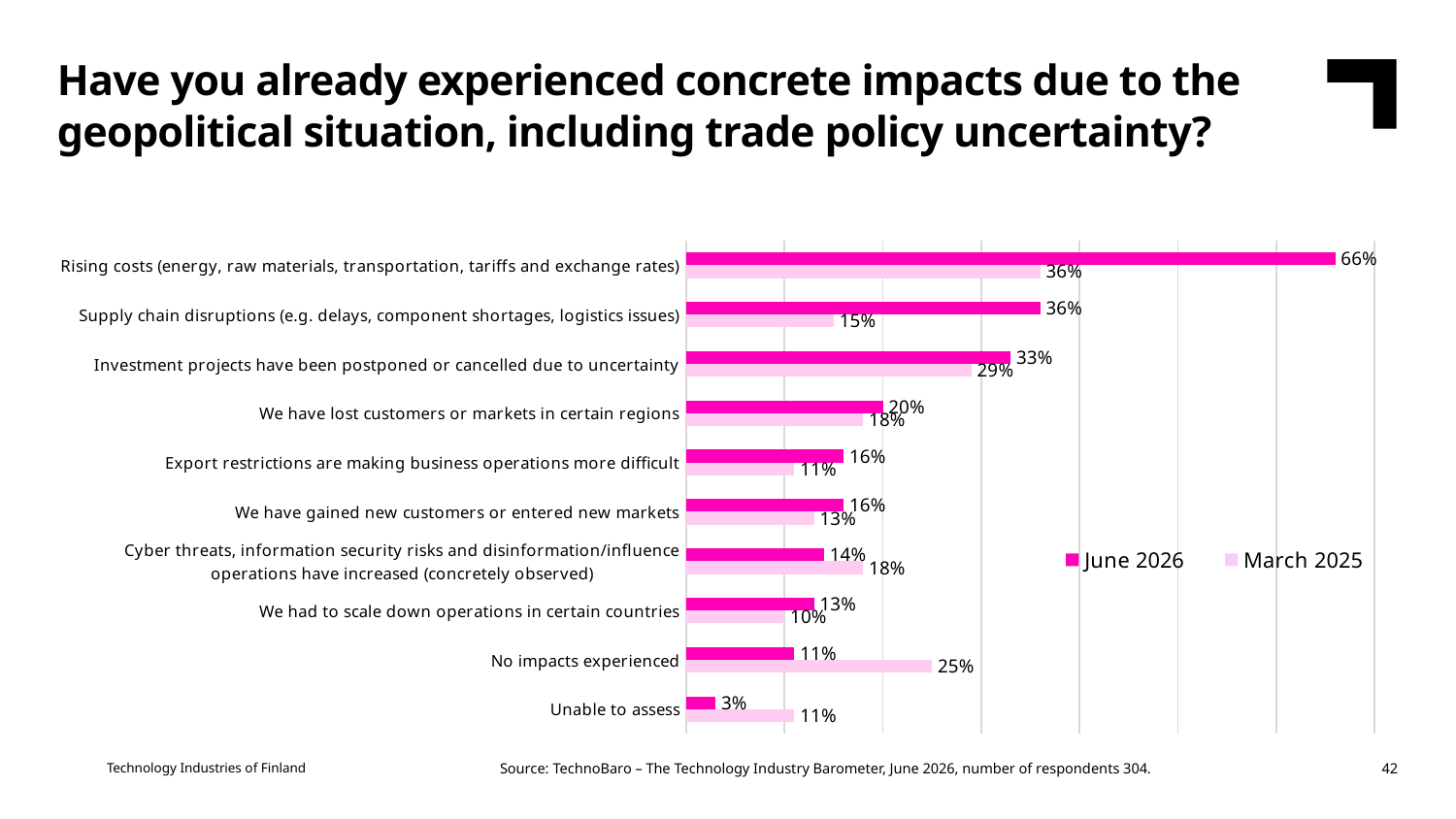
How many series does the legend list? 2 What is the June 2026 value for "Supply chain disruptions (e.g. delays, component shortages, logistics issues)"? 36% Which category has the lowest June 2026 value? Unable to assess What is the difference between the June 2026 and March 2025 values for "Rising costs (energy, raw materials, transportation, tariffs and exchange rates)"? 30% For "Supply chain disruptions (e.g. delays, component shortages, logistics issues)", which is larger: the June 2026 value or the March 2025 value? June 2026 What is the March 2025 value for "No impacts experienced"? 25% Which category has the highest June 2026 value? Rising costs (energy, raw materials, transportation, tariffs and exchange rates) What is the June 2026 value for "Rising costs (energy, raw materials, transportation, tariffs and exchange rates)"? 66% What kind of chart is shown on the slide? Bar chart What is the difference between the March 2025 and June 2026 values for "No impacts experienced"? 14% How many categories are shown in the chart? 10 For "Cyber threats, information security risks and disinformation/influence operations have increased (concretely observed)", which is larger: the June 2026 value or the March 2025 value? March 2025